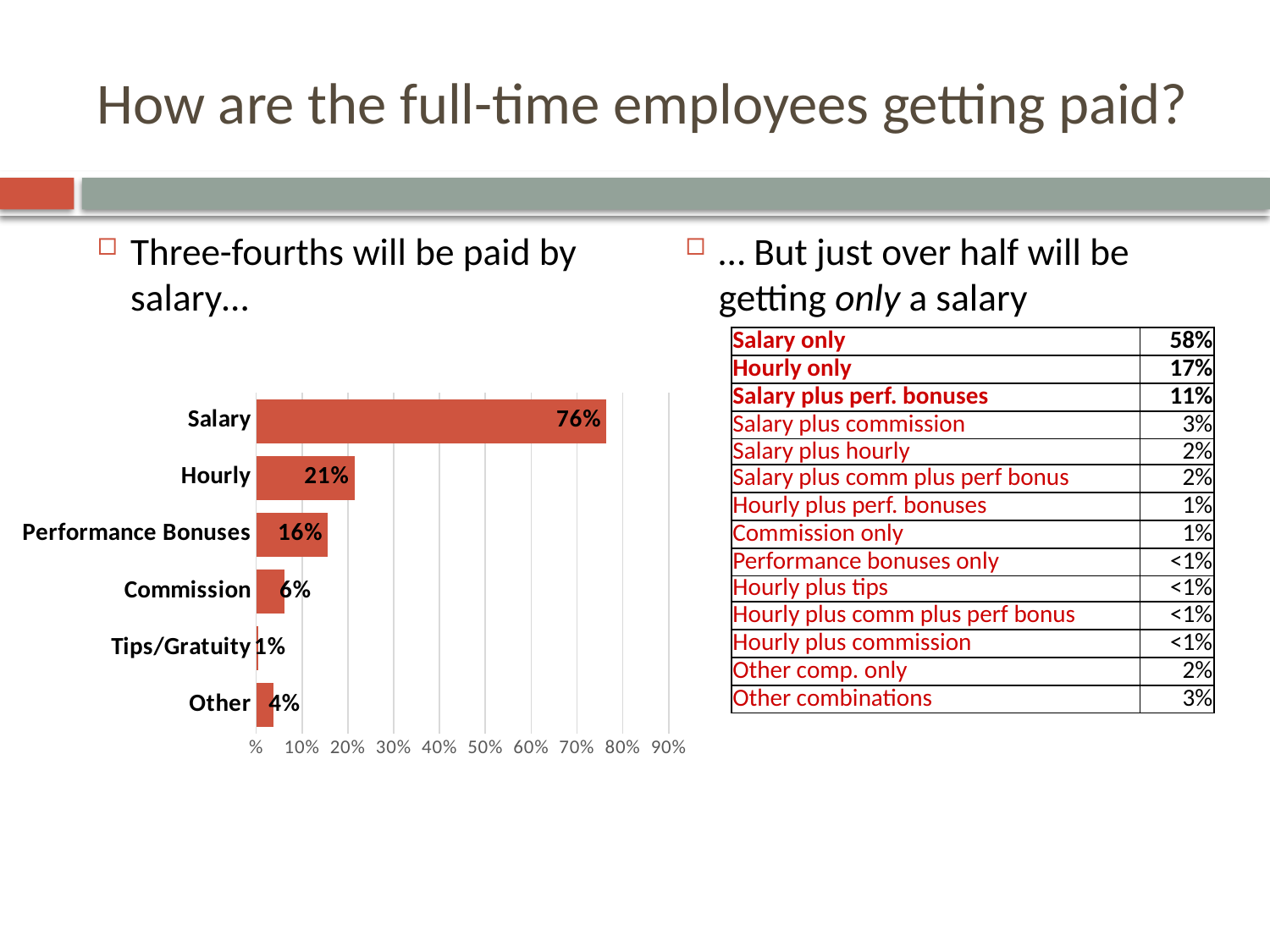
How many categories are shown in the bar chart? 6 What is the difference between the values for Salary and Hourly in the bar chart? 55% Which category has the highest value in the bar chart? Salary What is the value for Salary in the bar chart? 76% Which category has the lowest value in the bar chart? Tips/Gratuity What kind of chart is shown on the slide? Bar chart Is the value for Salary in the bar chart greater or less than 70%? greater What is the difference between the values for Performance Bonuses and Commission in the bar chart? 10% What is the value for Hourly in the bar chart? 21% What is the value for Performance Bonuses in the bar chart? 16% What is the value for Commission in the bar chart? 6% Which is larger in the bar chart, Commission or Other? Commission